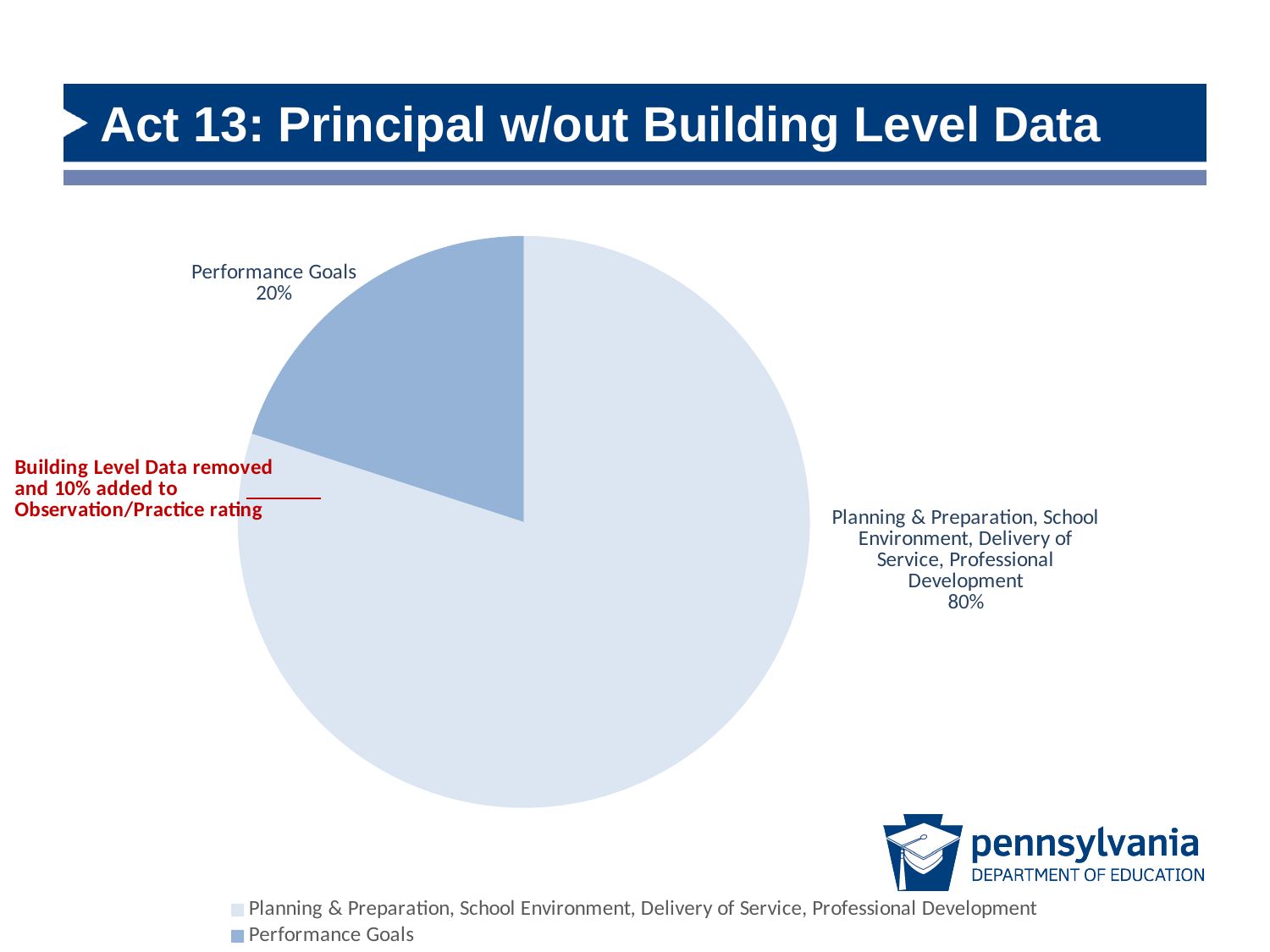
Which slice of the pie is the smallest? Performance Goals Which is larger, the Performance Goals slice or the Planning & Preparation, School Environment, Delivery of Service, Professional Development slice? Planning & Preparation, School Environment, Delivery of Service, Professional Development What share of the pie does the Planning & Preparation, School Environment, Delivery of Service, Professional Development slice represent? 80% What is the difference in percentage points between the Planning & Preparation, School Environment, Delivery of Service, Professional Development slice and the Performance Goals slice? 60 percentage points What share of the pie does Performance Goals represent? 20% How many entries does the legend list? 2 Which slice of the pie is the largest? Planning & Preparation, School Environment, Delivery of Service, Professional Development What is the title of the slide containing the pie chart? Act 13: Principal w/out Building Level Data What does the red annotation next to the pie chart say? Building Level Data removed and 10% added to Observation/Practice rating How many slices does the pie chart have? 2 What kind of chart is shown on the slide? pie chart